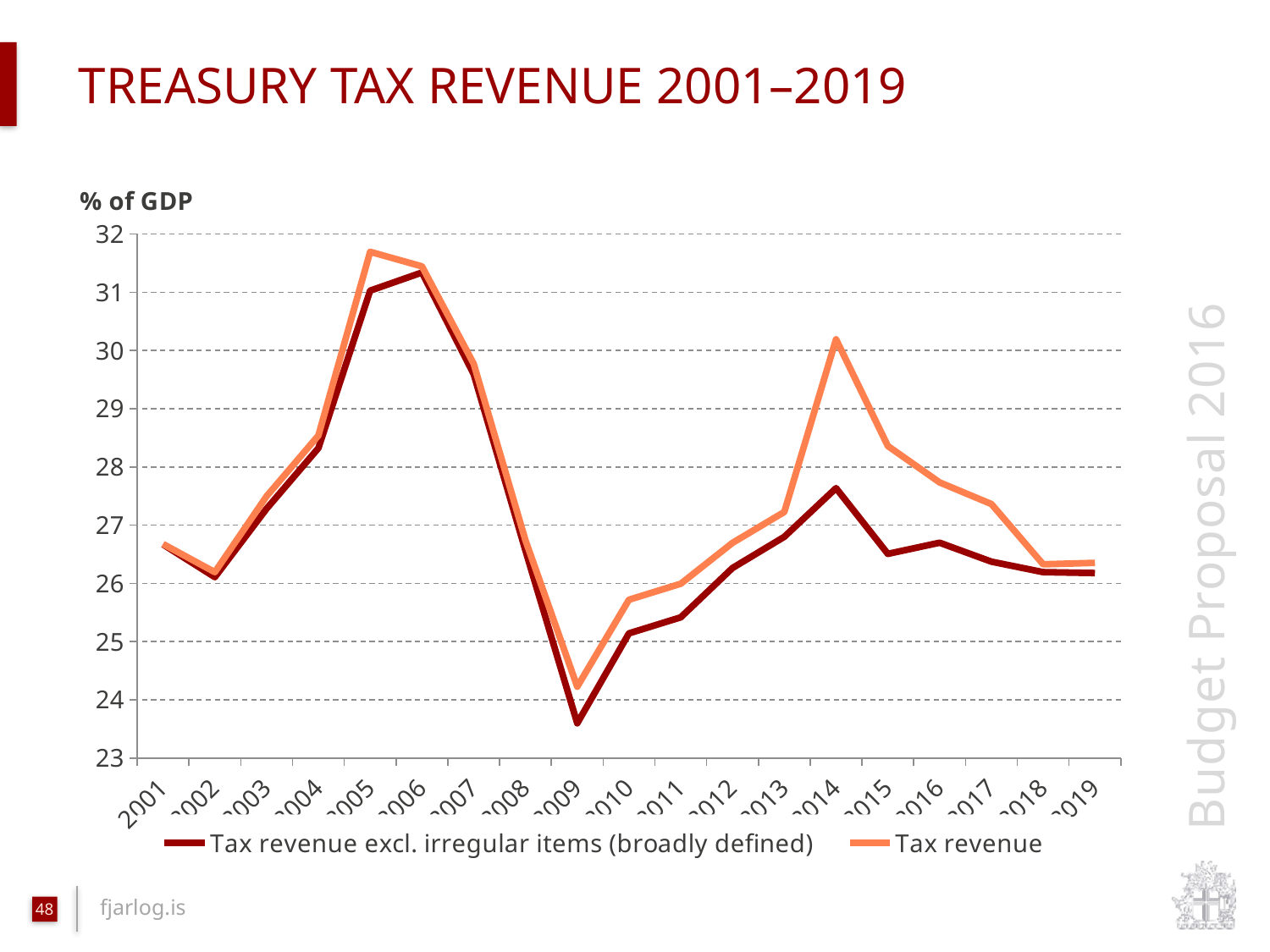
What unit is shown above the y axis? % of GDP How many years are plotted along the x axis? 19 In which year does the Tax revenue series reach its lowest value? 2009 Is the value for Tax revenue excl. irregular items (broadly defined) in 2009 greater or less than 24? less In 2014, which series has the higher value: Tax revenue or Tax revenue excl. irregular items (broadly defined)? Tax revenue What kind of chart is shown on the slide? line chart Does the Tax revenue series rise or fall between 2006 and 2009? fall In which year does the Tax revenue excl. irregular items (broadly defined) series reach its lowest value? 2009 Is the value for Tax revenue in 2005 greater or less than 31? greater Is the value for Tax revenue in 2014 greater or less than 29? greater In which year does the Tax revenue series reach its highest value? 2005 How many series does the legend list? 2